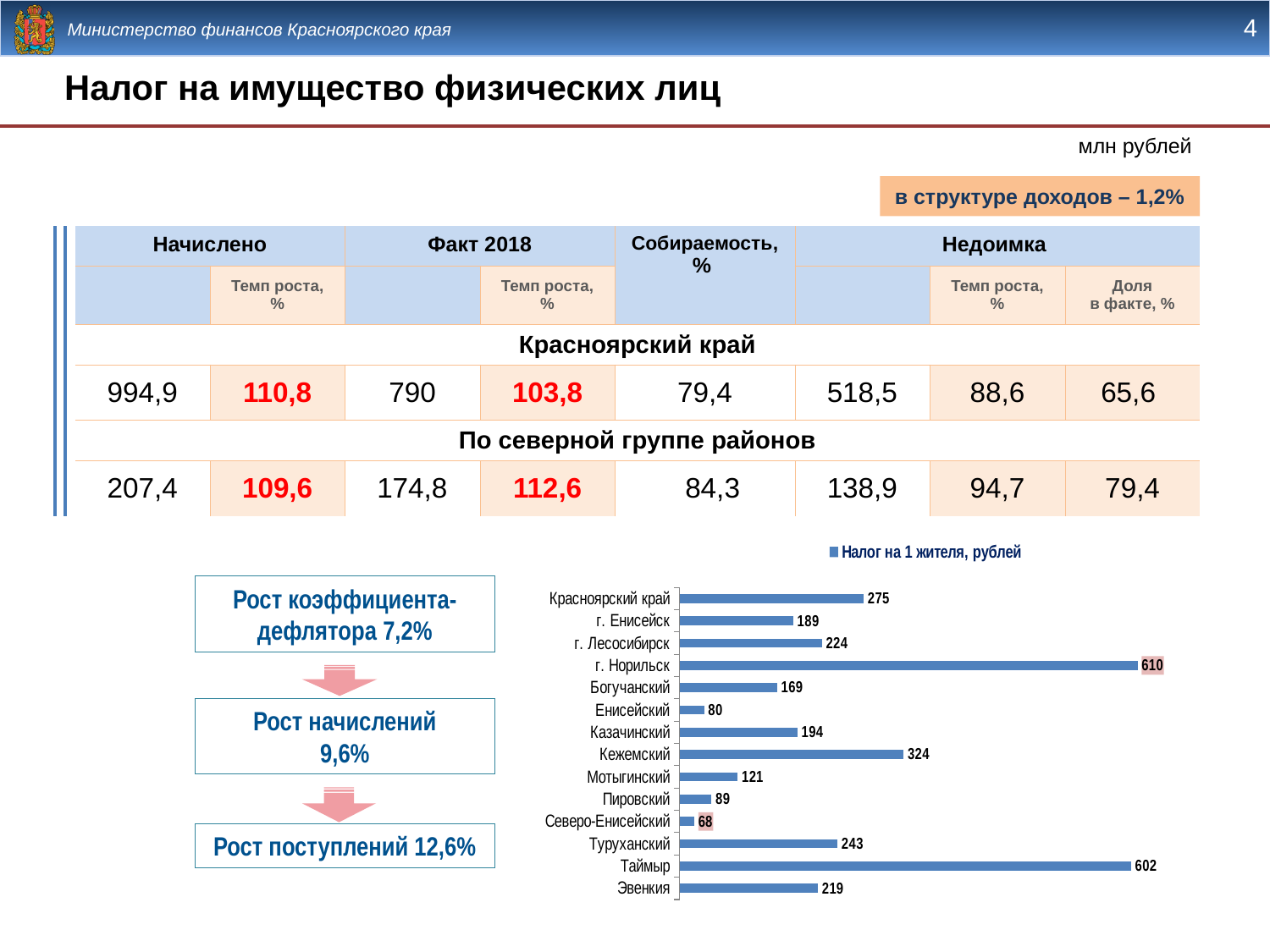
How many series does the legend of the chart list? 1 What is the difference between the values for г. Норильск and Таймыр in the chart 'Налог на 1 жителя, рублей'? 8 Which has a larger value in the chart 'Налог на 1 жителя, рублей': г. Лесосибирск or г. Енисейск? г. Лесосибирск What type of chart is shown on the slide? bar chart What is the value for Эвенкия in the chart 'Налог на 1 жителя, рублей'? 219 What is the value for Кежемский in the chart 'Налог на 1 жителя, рублей'? 324 How many categories are shown in the chart 'Налог на 1 жителя, рублей'? 14 What is the value for г. Норильск in the chart 'Налог на 1 жителя, рублей'? 610 Which category has the lowest value in the chart 'Налог на 1 жителя, рублей'? Северо-Енисейский Which category has the highest value in the chart 'Налог на 1 жителя, рублей'? г. Норильск What is the difference between the values for Туруханский and Мотыгинский in the chart 'Налог на 1 жителя, рублей'? 122 What is the value for Красноярский край in the chart 'Налог на 1 жителя, рублей'? 275